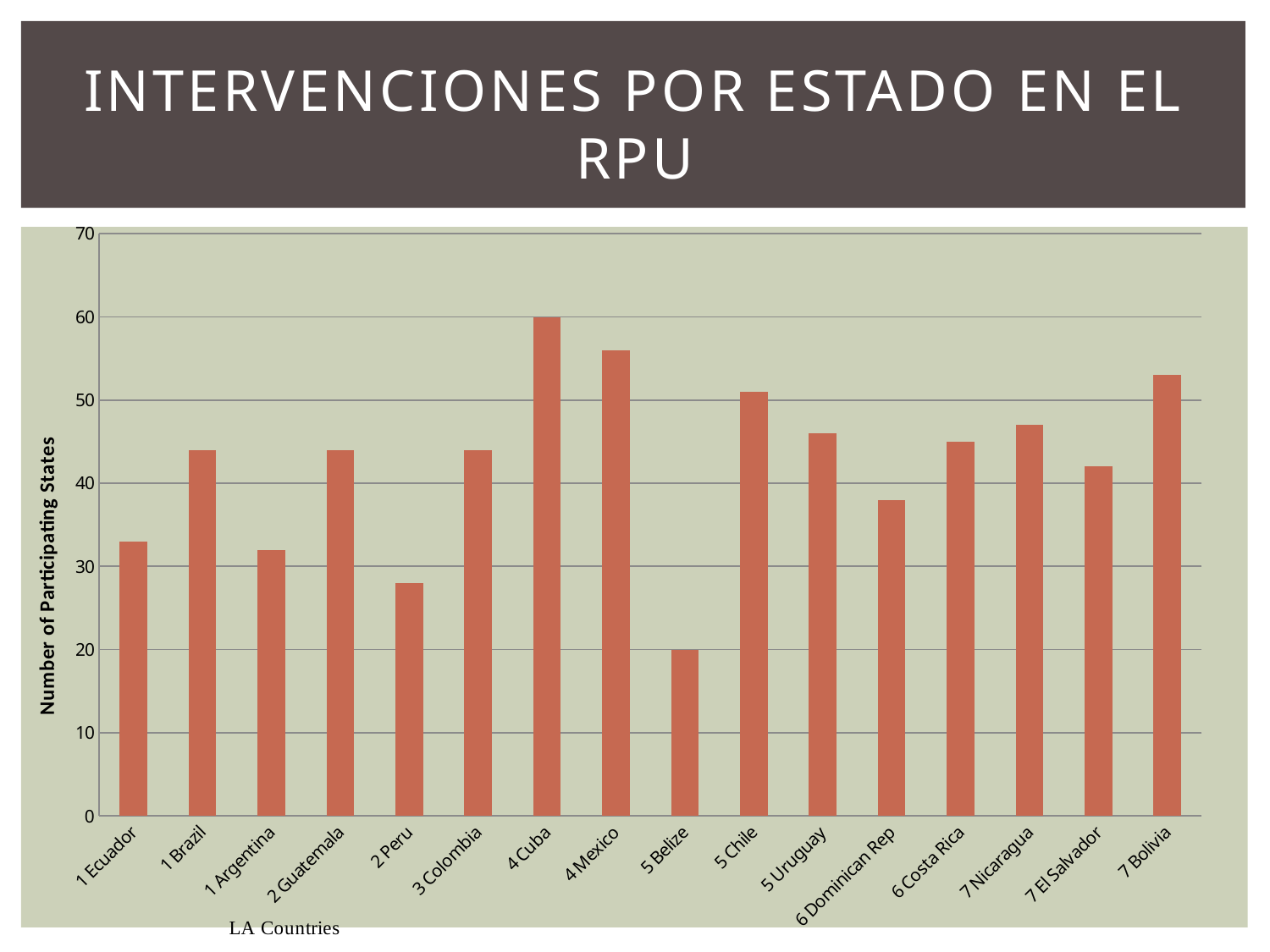
Is the value for 6 Dominican Rep greater or less than 40? less What is the difference between the values for 4 Cuba and 5 Belize? 40 What is the number of participating states for 5 Belize? 20 Which country has the highest number of participating states? 4 Cuba What kind of chart is shown on the slide? bar chart Which country has the lowest number of participating states? 5 Belize What is the label of the vertical axis of the chart? Number of Participating States How many countries are shown on the x axis of the chart? 16 Which has a higher value, 4 Mexico or 5 Chile? 4 Mexico Is the value for 2 Peru greater or less than 30? less Is the value for 4 Mexico greater or less than 50? greater What is the number of participating states for 4 Cuba? 60